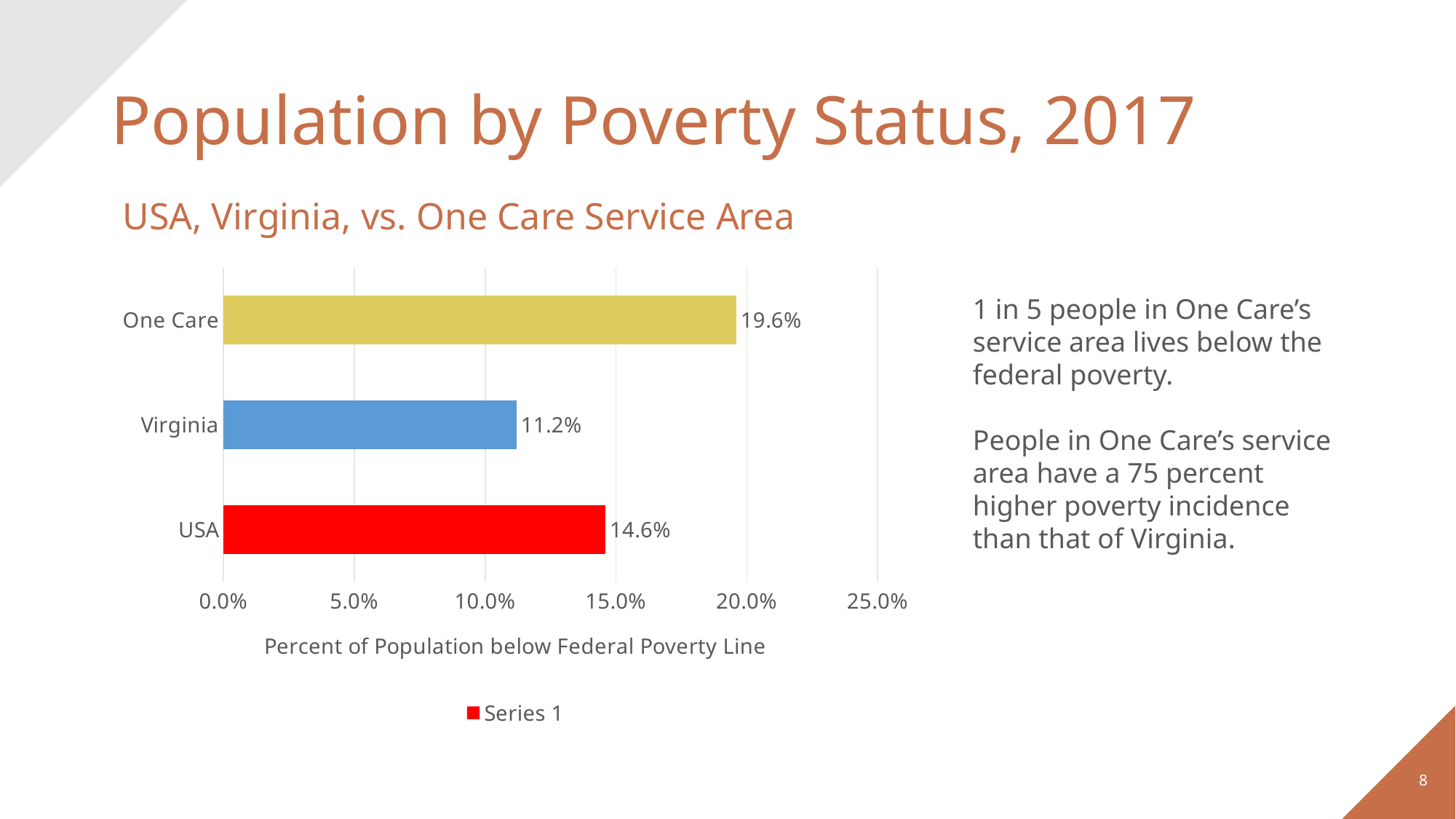
Which has a higher percent of population below the federal poverty line, USA or Virginia? USA Which category has the lowest percent of population below the federal poverty line? Virginia What is the percent of population below the federal poverty line for the USA? 14.6% What kind of chart is shown on the slide? bar chart What is the percent of population below the federal poverty line for One Care? 19.6% How many categories are shown in the chart? 3 What is the difference in percentage points between One Care and Virginia? 8.4 What is the x-axis title of the chart? Percent of Population below Federal Poverty Line What is the percent of population below the federal poverty line for Virginia? 11.2% Is the value for One Care greater or less than 15.0%? greater What is the difference in percentage points between the USA and Virginia? 3.4 Which category has the highest percent of population below the federal poverty line? One Care